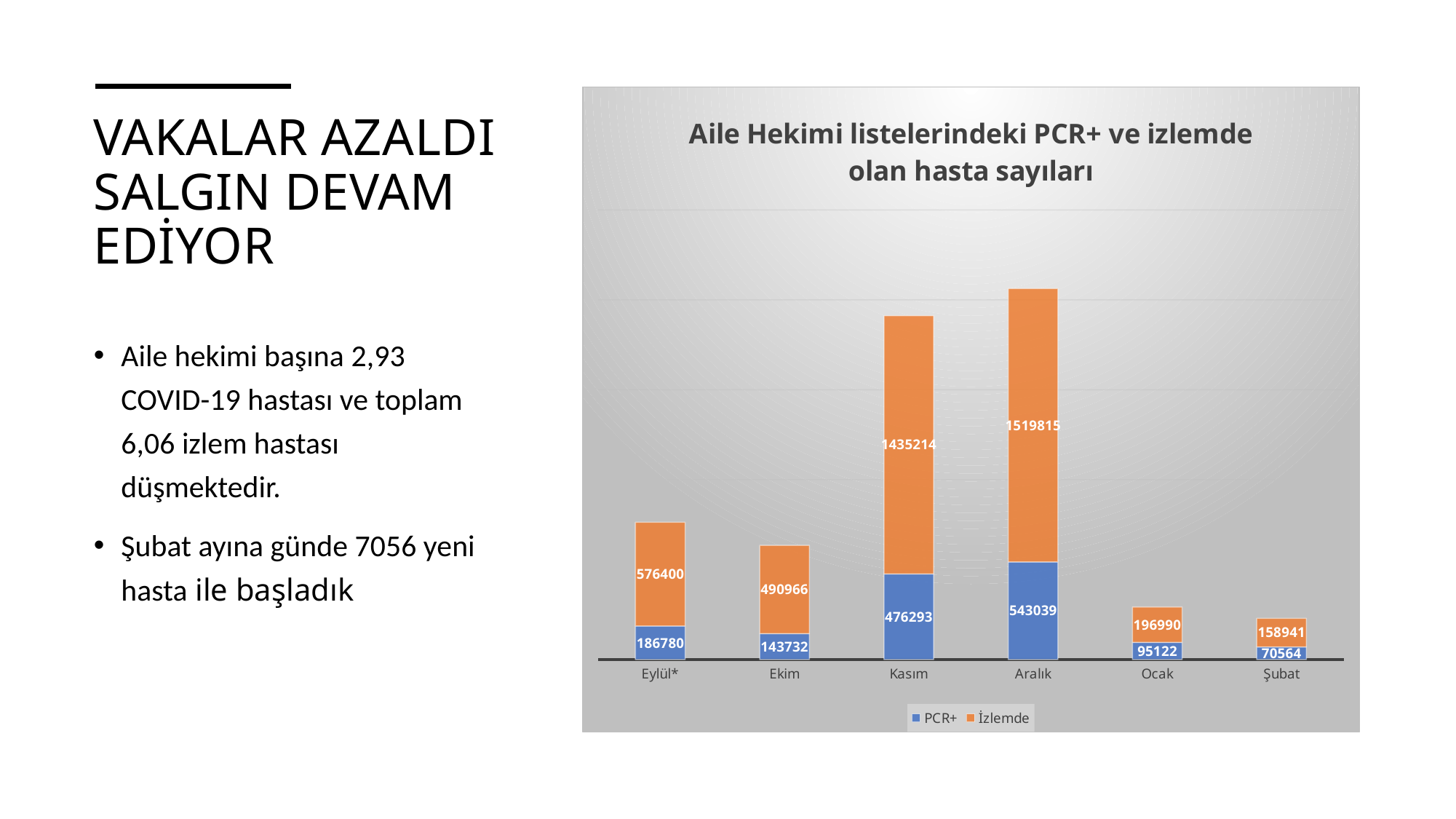
What is the difference between the İzlemde values for Eylül* and Ekim? 85434 Which is larger, the PCR+ value for Eylül* or the PCR+ value for Ekim? Eylül* What is the difference between the PCR+ values for Aralık and Kasım? 66746 What is the total of the stacked bar for Ocak? 292112 Which month has the lowest PCR+ value? Şubat What type of chart is shown on the slide? Stacked bar chart How many months are shown on the x axis? 6 How many series does the legend list? 2 What is the PCR+ value for Aralık? 543039 What is the İzlemde value for Kasım? 1435214 What is the PCR+ value for Şubat? 70564 Which month has the highest İzlemde value? Aralık